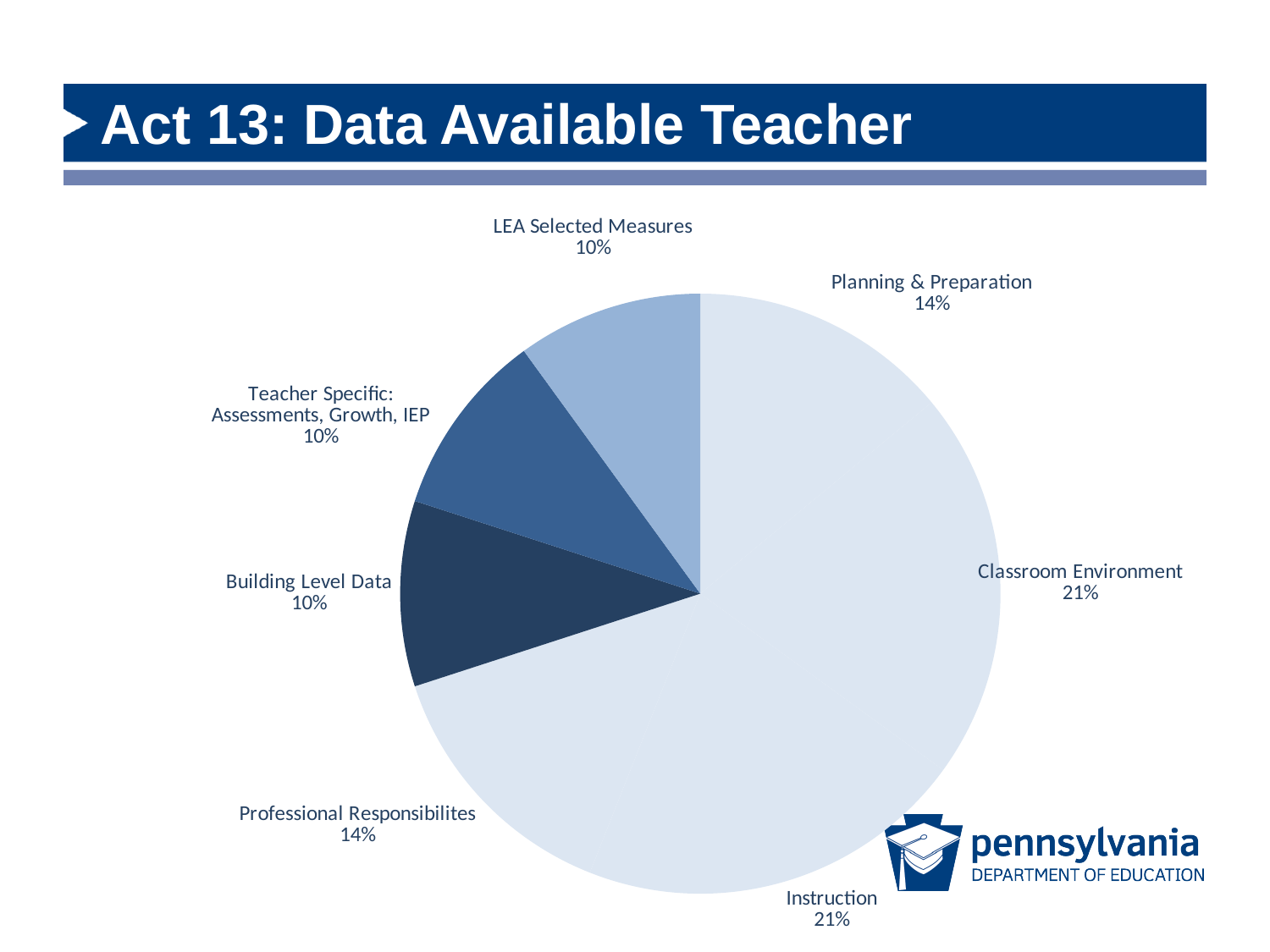
What kind of chart is shown on the slide? Pie chart What share of the pie does Classroom Environment represent? 21% How many slices does the pie chart have? 7 What share is labelled for Teacher Specific: Assessments, Growth, IEP? 10% Which is larger, the share for Classroom Environment or the share for Building Level Data? Classroom Environment What is the title of the slide containing the pie chart? Act 13: Data Available Teacher What is the difference in percentage points between Instruction and LEA Selected Measures? 11 percentage points What percentage is shown for Instruction? 21% What percentage is shown for LEA Selected Measures? 10% What percentage is shown for Planning & Preparation? 14% What percentage is shown for Building Level Data? 10% What share is labelled for Professional Responsibilites? 14%